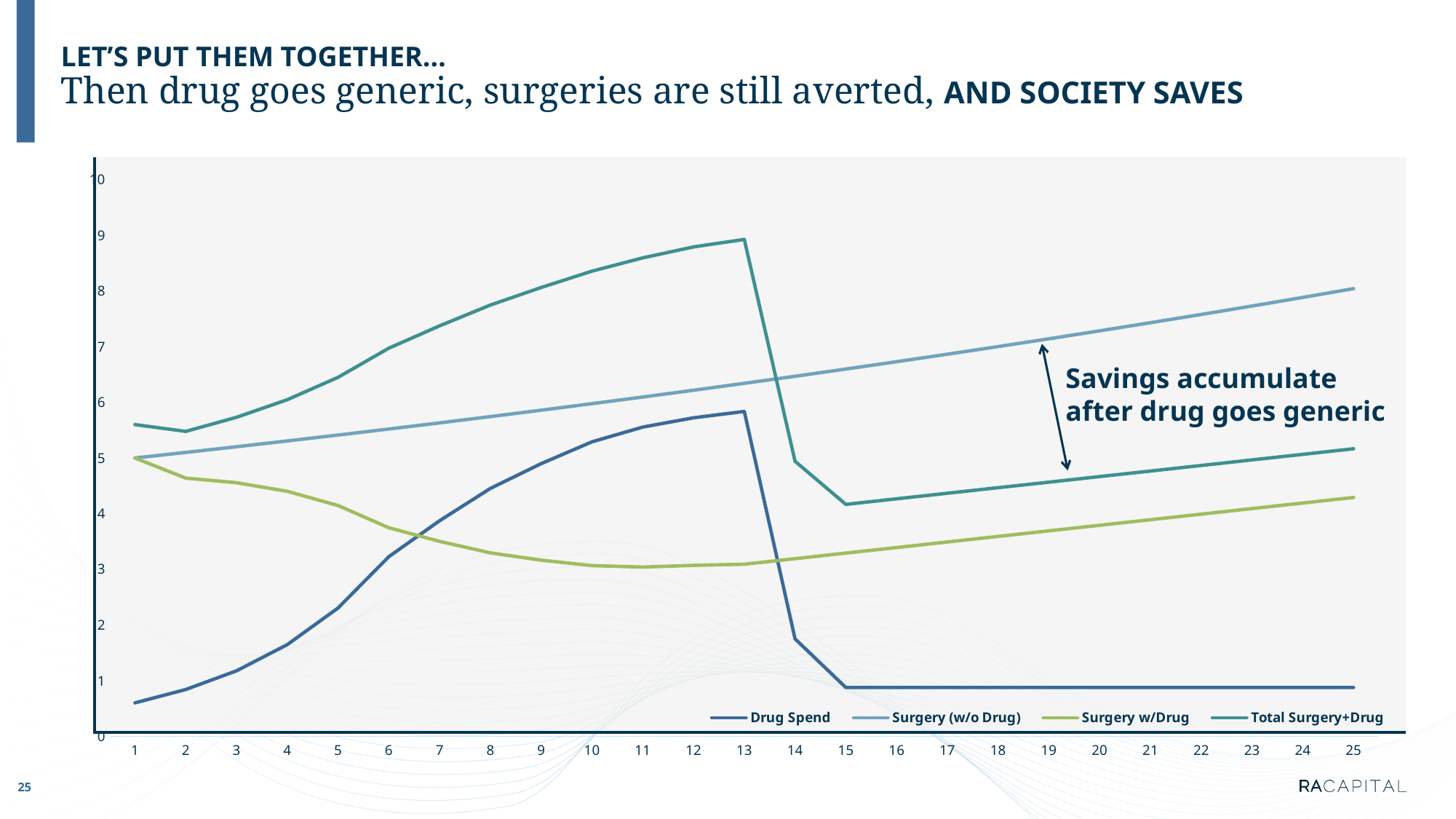
Which series has the lowest value at x = 20? Drug Spend Is the value for Total Surgery+Drug at x = 13 greater or less than 8? greater How many points are labelled along the x axis? 25 Is the value for Drug Spend at x = 20 greater or less than 2? less How many series does the legend list? 4 What kind of chart is shown on the slide? line chart At x = 25, which is higher: Surgery (w/o Drug) or Total Surgery+Drug? Surgery (w/o Drug) Which series has the highest value at x = 13? Total Surgery+Drug Is the value for Surgery w/Drug at x = 11 greater or less than 4? less Does the Surgery (w/o Drug) line rise or fall from x = 1 to x = 25? rise What does the annotation next to the double-headed arrow say? Savings accumulate after drug goes generic